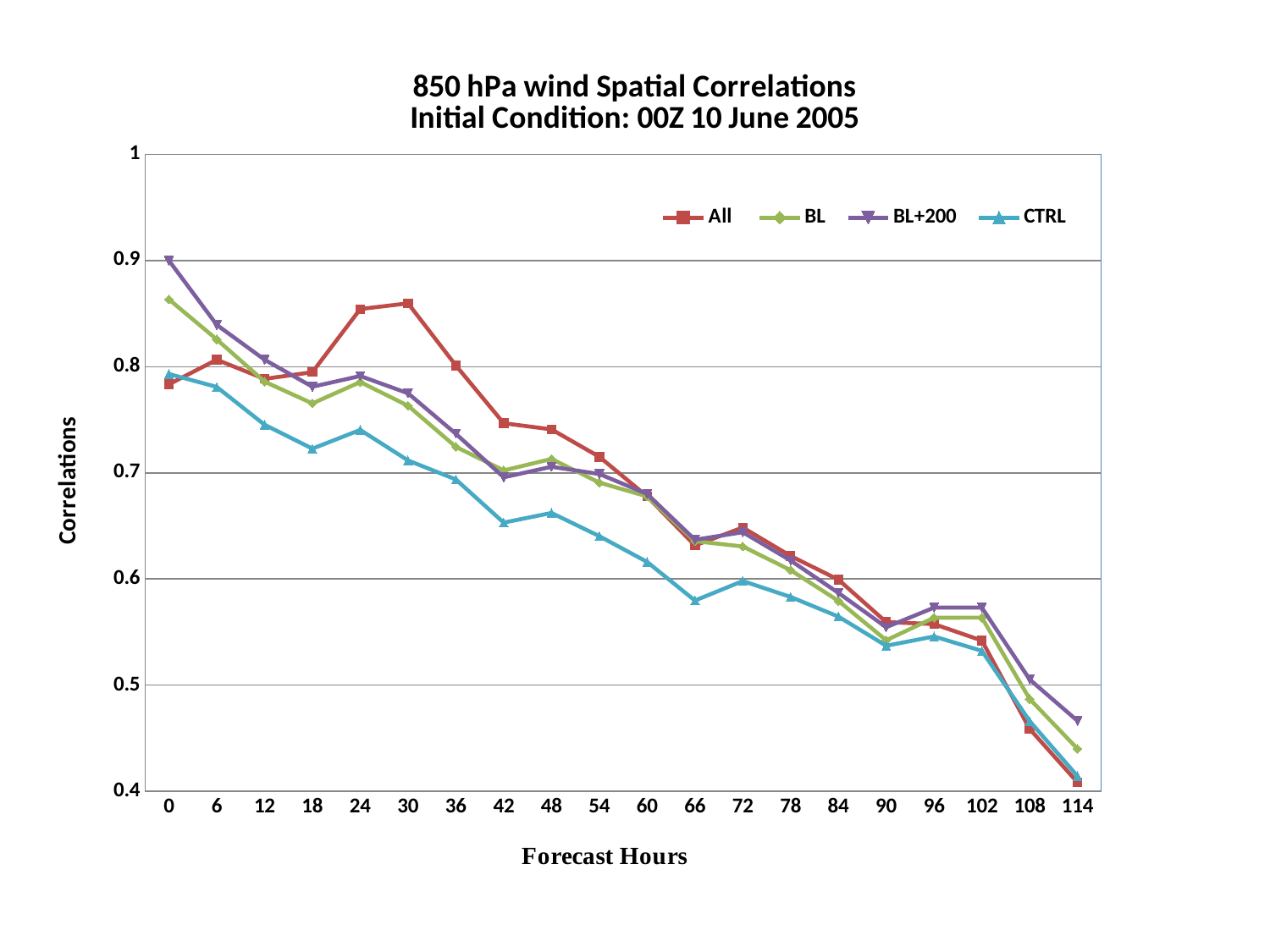
Do the correlation values generally rise or fall as forecast hours increase? fall At forecast hour 114, which is larger, the value for BL+200 or the value for All? BL+200 Which series has the lowest correlation at forecast hour 66? CTRL What kind of chart is shown on the slide? line chart What is the label of the x axis? Forecast Hours Is the value for CTRL at forecast hour 66 greater or less than 0.6? less Which series has the highest correlation at forecast hour 0? BL+200 Is the value for All at forecast hour 30 greater or less than 0.8? greater How many series does the legend list? 4 At forecast hour 24, which is larger, the value for All or the value for CTRL? All How many forecast hour points are plotted along the x axis? 20 Which series has the highest correlation at forecast hour 30? All